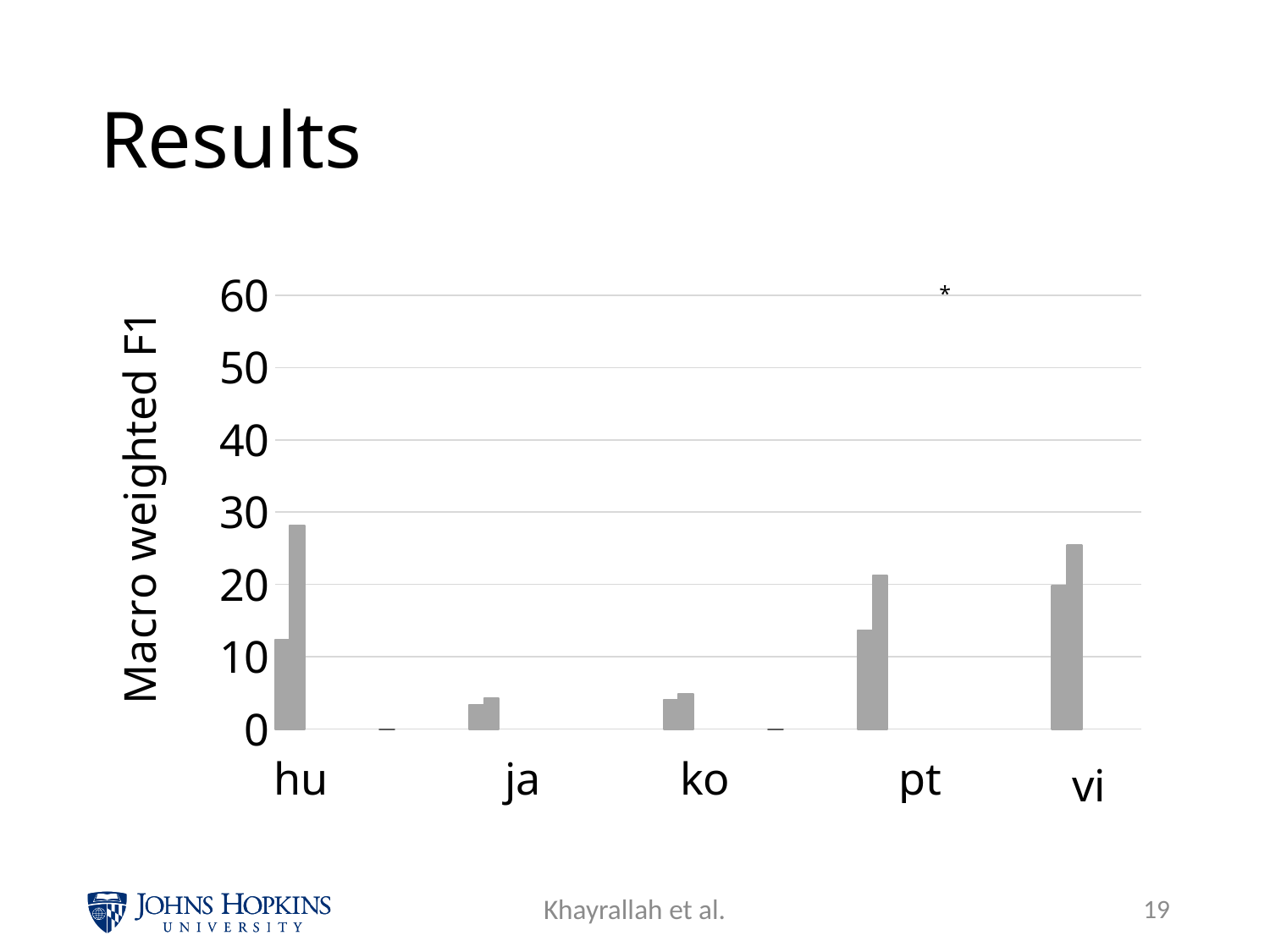
Is the tallest bar for vi greater or less than 30? less Is the tallest bar for ko greater or less than 10? less How many category labels are shown along the x axis? 5 Is the tallest bar for vi greater or less than 20? greater Which has a taller bar, hu or ja? hu What kind of chart is shown on the slide? bar chart What is the label of the vertical axis? Macro weighted F1 Which has a taller bar, pt or ko? pt